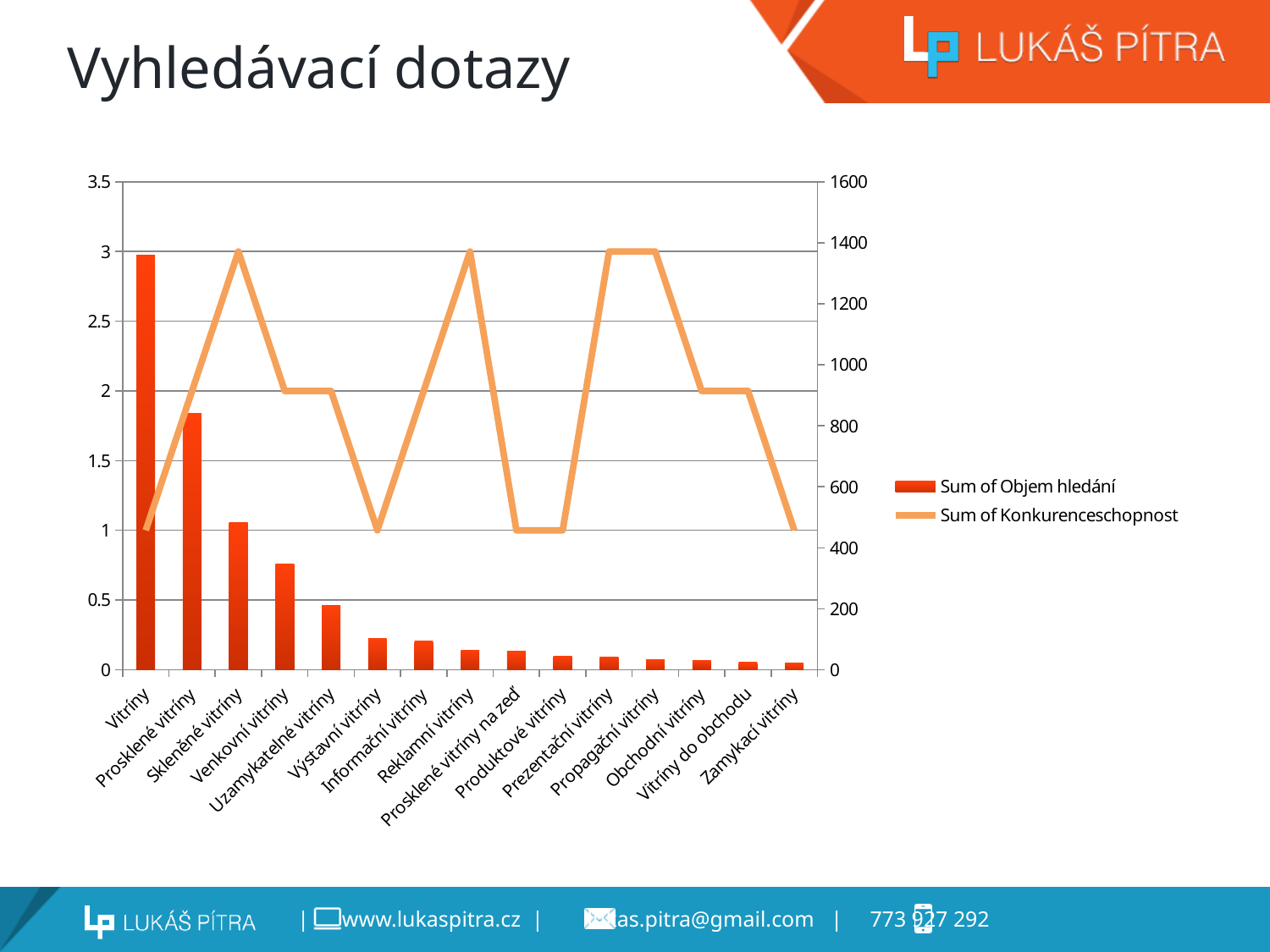
Is the Sum of Objem hledání bar for Venkovní vitríny greater or less than 0.5? greater Is the Sum of Konkurenceschopnost value for Vitríny greater or less than 600? less Do the Sum of Objem hledání bars rise or fall from left to right along the x axis? fall Is the Sum of Objem hledání bar for Vitríny greater or less than 2.5? greater How many categories are shown on the x axis of the chart? 15 Which category has the highest bar for Sum of Objem hledání? Vitríny Which has the larger Sum of Objem hledání bar, Skleněné vitríny or Venkovní vitríny? Skleněné vitríny Which series is drawn as a line in the chart? Sum of Konkurenceschopnost How many series does the chart legend list? 2 What is the title of the chart on the slide? Vyhledávací dotazy